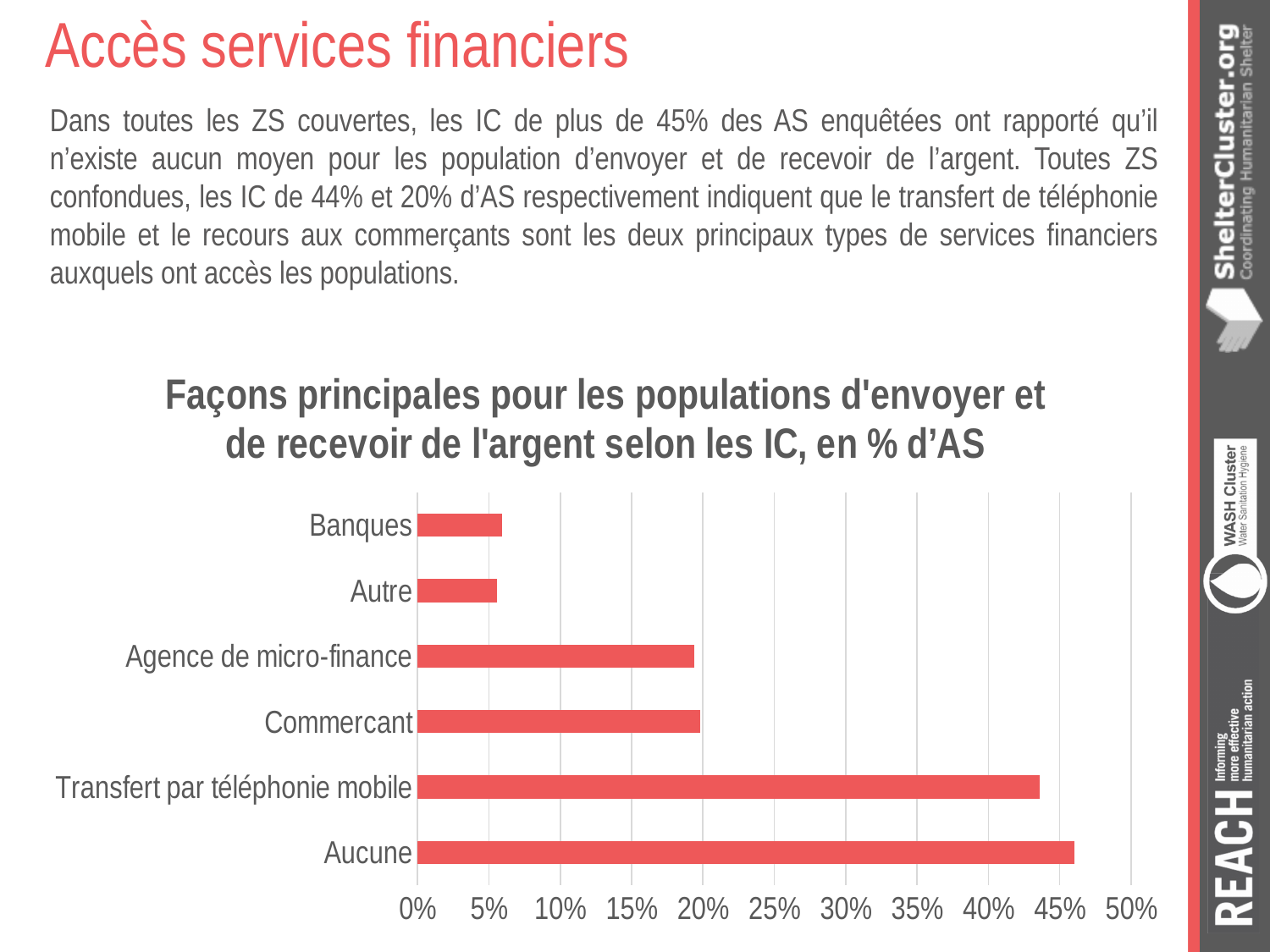
What colour are the bars in the chart? red Is the value for Banques greater or less than 10%? less Is the value for Aucune greater or less than 40%? greater Is the value for Transfert par téléphonie mobile greater or less than 45%? less What kind of chart is shown on the slide? bar chart How many categories are shown in the chart? 6 Which is larger, the value for Aucune or the value for Transfert par téléphonie mobile? Aucune What is the title of the chart? Façons principales pour les populations d'envoyer et de recevoir de l'argent selon les IC, en % d'AS Which category has the highest value in the chart? Aucune Which is larger, the value for Transfert par téléphonie mobile or the value for Commercant? Transfert par téléphonie mobile